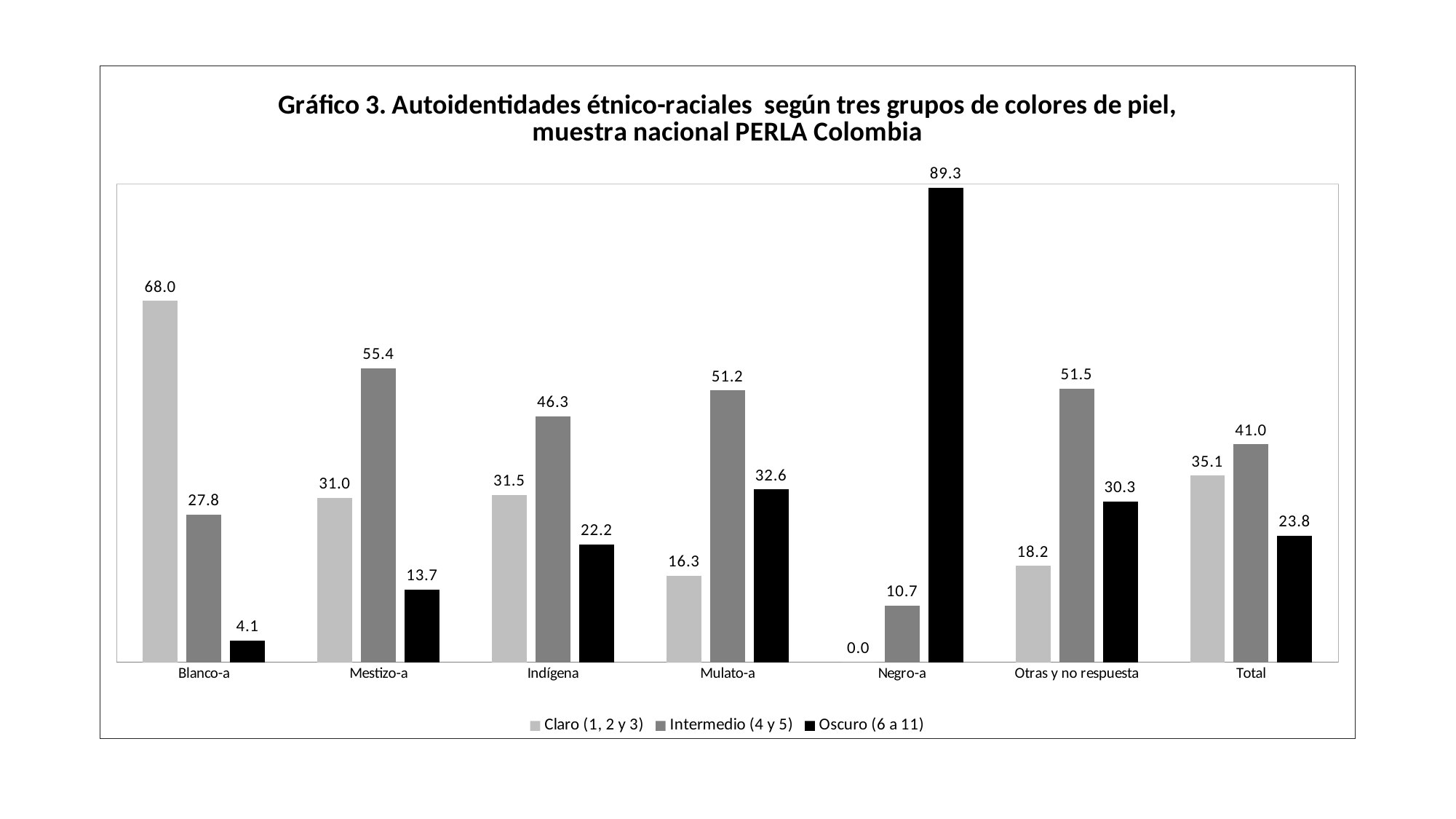
What kind of chart is shown on the slide? Bar chart Which category has the highest value for the Oscuro (6 a 11) series? Negro-a Which category has the lowest value for the Claro (1, 2 y 3) series? Negro-a How many series does the legend list? 3 In the Indígena category, which is larger: Intermedio (4 y 5) or Oscuro (6 a 11)? Intermedio (4 y 5) What is the value for Oscuro (6 a 11) in the Otras y no respuesta category? 30.3 What is the value for Claro (1, 2 y 3) in the Blanco-a category? 68.0 What is the difference between the Intermedio (4 y 5) and Claro (1, 2 y 3) values in the Total category? 5.9 What is the value for Oscuro (6 a 11) in the Negro-a category? 89.3 How many categories are shown on the x axis? 7 Which series is shown in black in the legend? Oscuro (6 a 11) What is the value for Intermedio (4 y 5) in the Mestizo-a category? 55.4